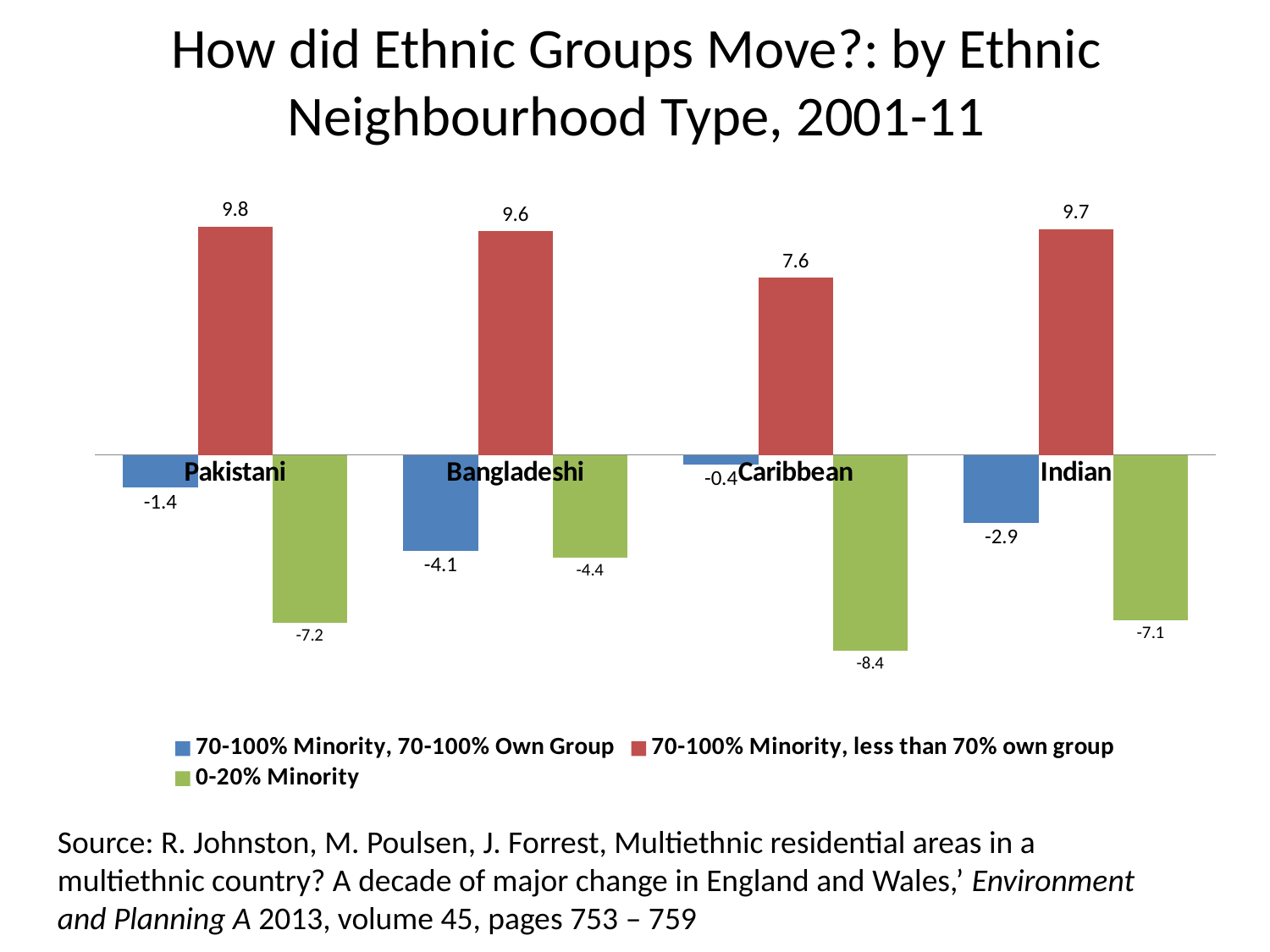
What is the value for Pakistani in the '70-100% Minority, less than 70% own group' series? 9.8 What is the difference between the '70-100% Minority, less than 70% own group' values for Pakistani and Caribbean? 2.2 Which colour represents the '0-20% Minority' series? Green What kind of chart is shown on the slide? Bar chart How many ethnic groups are shown on the x axis? 4 What is the value for Indian in the '0-20% Minority' series? -7.1 What is the value for Bangladeshi in the '70-100% Minority, 70-100% Own Group' series? -4.1 Which is larger in the '70-100% Minority, 70-100% Own Group' series: the value for Caribbean or the value for Indian? Caribbean What is the value for Caribbean in the '0-20% Minority' series? -8.4 How many series does the legend list? 3 Which ethnic group has the highest value in the '70-100% Minority, less than 70% own group' series? Pakistani Which ethnic group has the lowest value in the '0-20% Minority' series? Caribbean